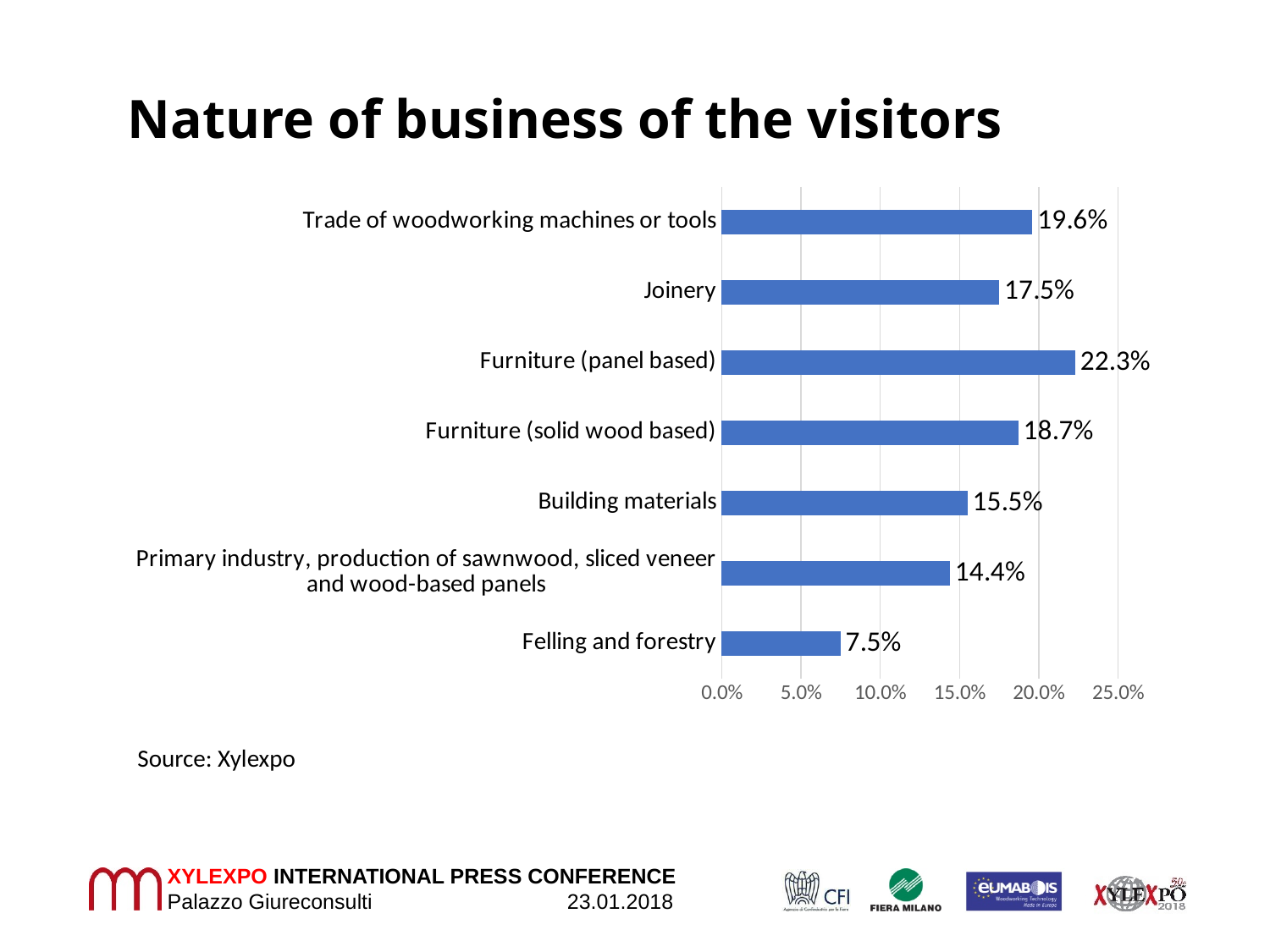
How many categories of business are shown in the chart? 7 What is the difference between Furniture (panel based) and Furniture (solid wood based)? 3.6% Which is larger, Building materials or Joinery? Joinery Is the value for Building materials greater or less than 15.0%? greater Which nature of business has the highest share of visitors? Furniture (panel based) Which nature of business has the lowest share of visitors? Felling and forestry What percentage of visitors are in the trade of woodworking machines or tools? 19.6% What is the title of the chart on the slide? Nature of business of the visitors What is the value shown for Felling and forestry? 7.5% What kind of chart is shown on the slide? Bar chart What is the value shown for Joinery? 17.5% What is the value for Primary industry, production of sawnwood, sliced veneer and wood-based panels? 14.4%